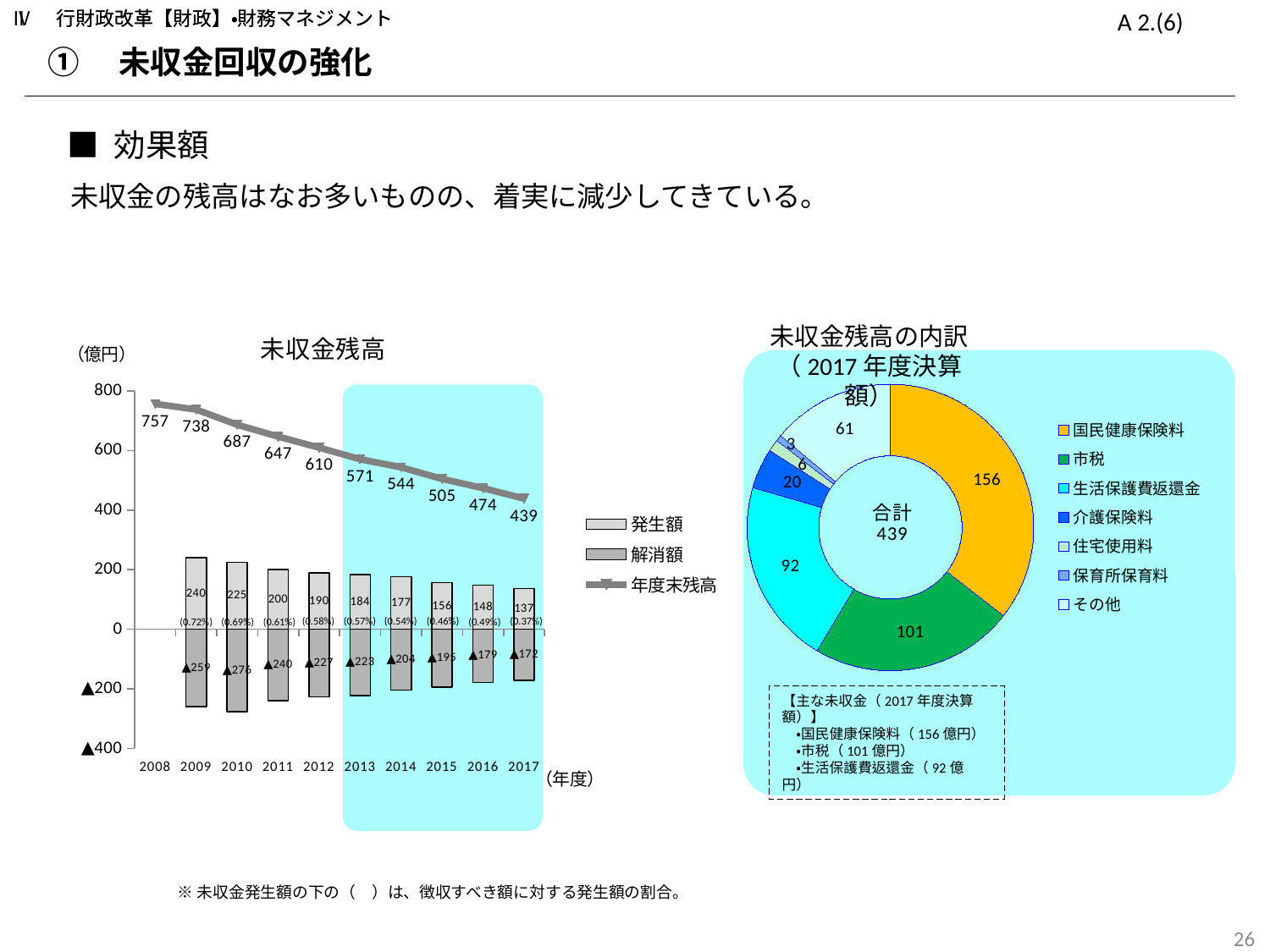
How many series does the legend of the 未収金残高 chart list? 3 In the 未収金残高 chart, how many years are shown on the x axis? 10 What kind of chart is the 未収金残高の内訳 chart? doughnut (pie) chart In the 未収金残高の内訳 chart, which category has the smallest value? 保育所保育料 In the 未収金残高 chart, what is the 発生額 value for 2015? 156 What total (合計) is shown in the centre of the 未収金残高の内訳 chart? 439 In the 未収金残高 chart, by how much did the 年度末残高 fall from 2008 to 2017? 318 In the 未収金残高 chart, what is the 年度末残高 value for 2012? 610 In the 未収金残高 chart, does the 年度末残高 line rise or fall from 2008 to 2017? fall In the 未収金残高 chart, what is the 解消額 value labelled for 2010? ▲276 In the 未収金残高の内訳 chart, which category has the largest value? 国民健康保険料 In the 未収金残高の内訳 chart, which is larger, 市税 or 生活保護費返還金? 市税